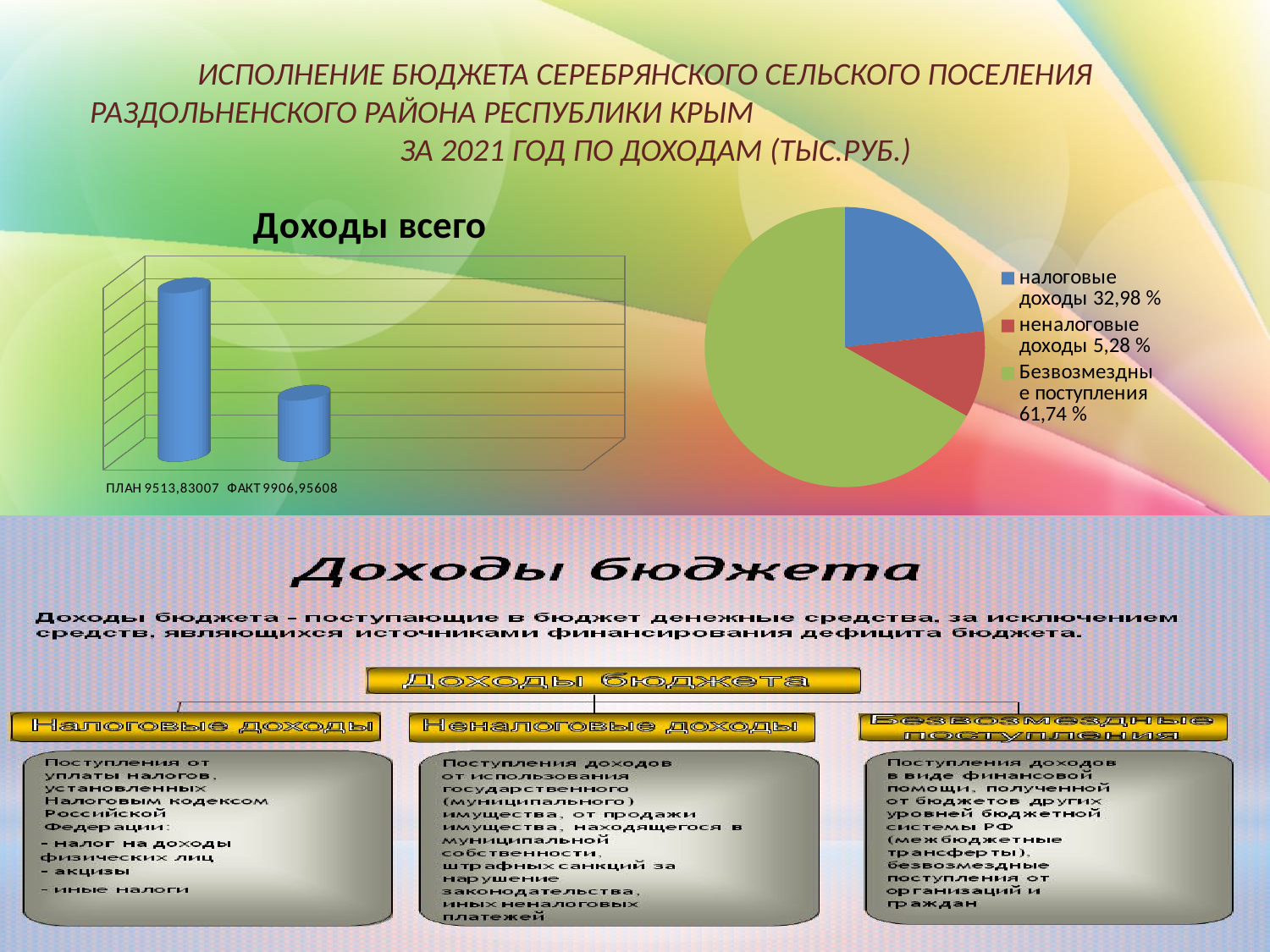
In the chart titled "Доходы всего", which bar is taller, the left one or the right one? the left one In the pie chart on the right, what share is shown for "налоговые доходы"? 32,98 % In the pie chart on the right, what share is shown for "Безвозмездные поступления"? 61,74 % In the pie chart on the right, what is the difference in percentage points between "Безвозмездные поступления" and "налоговые доходы"? 28,76 % In the pie chart on the right, what colour is the slice for "Безвозмездные поступления"? green In the pie chart on the right, which category has the smallest share? неналоговые доходы In the pie chart on the right, what share is shown for "неналоговые доходы"? 5,28 % How many bars are plotted in the chart titled "Доходы всего"? 2 In the pie chart on the right, which category has the largest share? Безвозмездные поступления In the pie chart on the right, how many categories does the legend list? 3 What kind of chart is the chart on the right side of the slide with the legend "налоговые доходы", "неналоговые доходы", "Безвозмездные поступления"? pie chart What kind of chart is the chart titled "Доходы всего"? bar chart